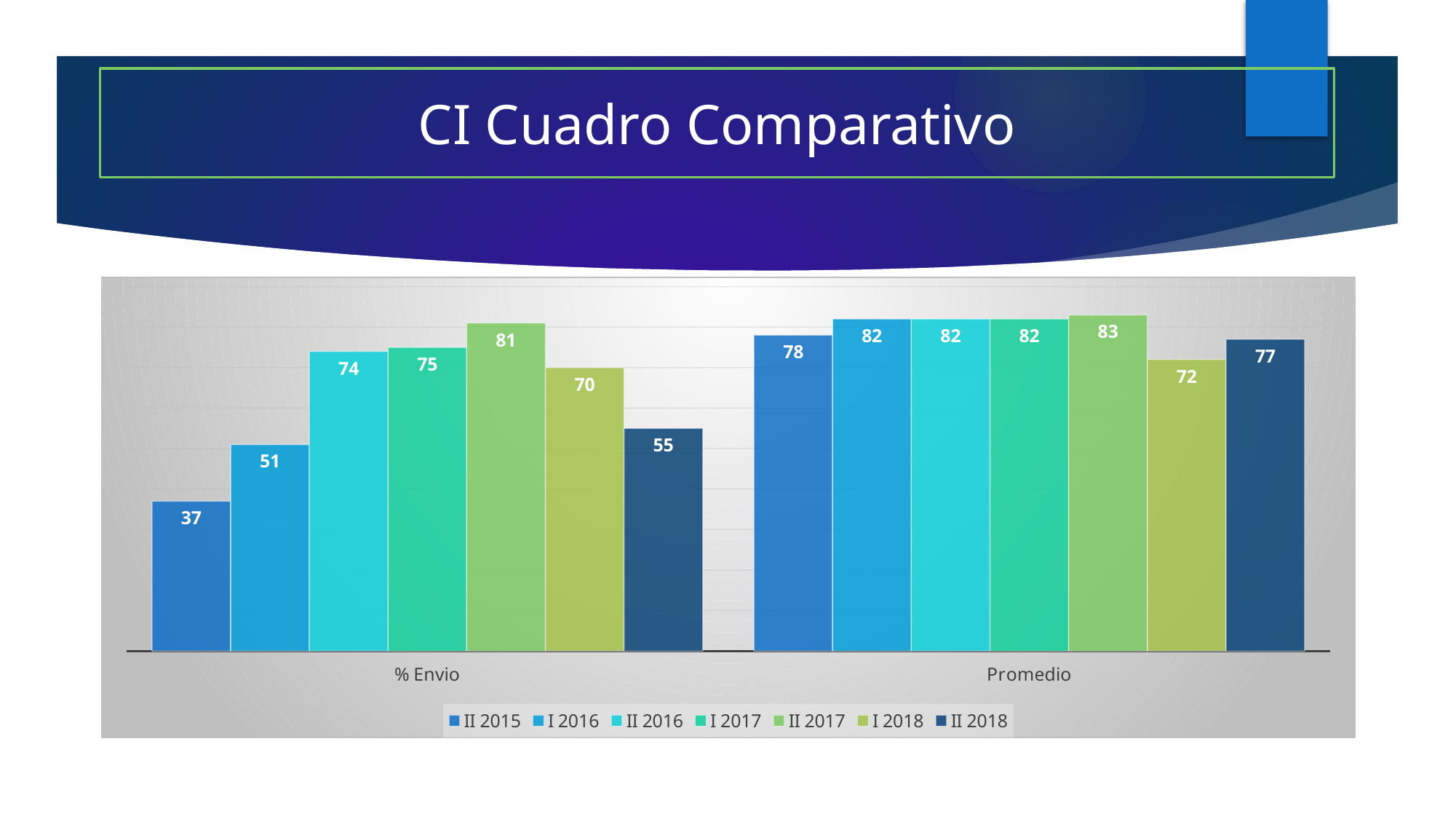
Which is larger for I 2018: the % Envio value or the Promedio value? Promedio What is the title of the slide containing the chart? CI Cuadro Comparativo What is the % Envio value for II 2018? 55 Which series has the lowest Promedio value? I 2018 What is the % Envio value for II 2015? 37 What is the difference between the % Envio values for II 2017 and II 2018? 26 How many categories are shown on the x axis? 2 What is the Promedio value for I 2018? 72 What kind of chart is shown on the slide? Bar chart How many series does the legend list? 7 Which series has the highest % Envio value? II 2017 What is the difference between the Promedio and % Envio values for II 2015? 41